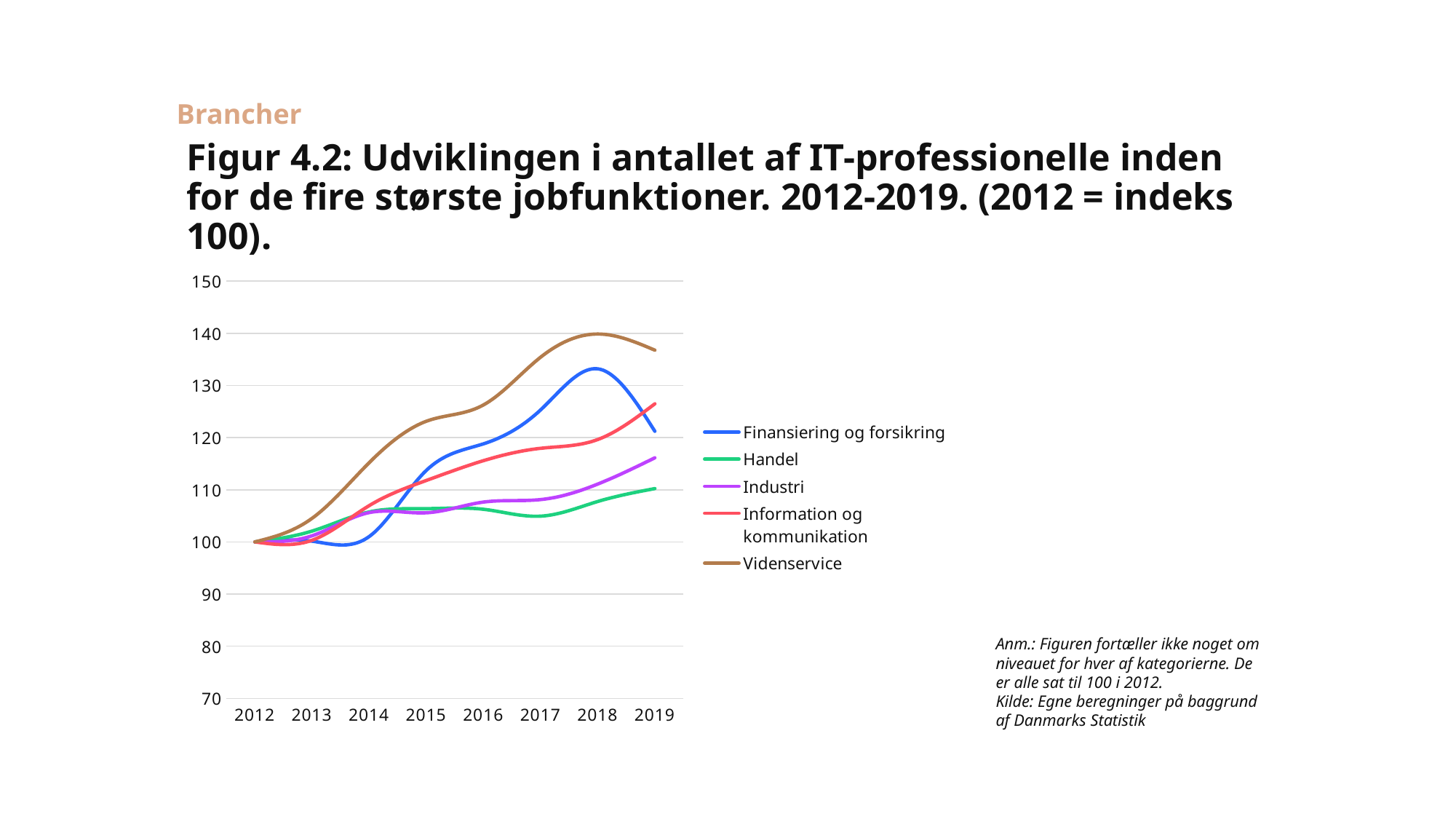
Is the value for Handel in 2019 greater or less than 120? less Which series has the highest value in 2019? Videnservice Is the value for Videnservice in 2018 greater or less than 130? greater Which colour is used for the Videnservice line in the legend? brown What is the index value for all series in 2012? 100 Is the value for Finansiering og forsikring in 2018 greater or less than 130? greater Which series has the lowest value in 2019? Handel In 2019, which is larger: Information og kommunikation or Finansiering og forsikring? Information og kommunikation How many years are shown on the x axis? 8 How many series does the legend list? 5 What kind of chart is shown on the slide? line chart Does the value for Finansiering og forsikring rise or fall from 2018 to 2019? fall